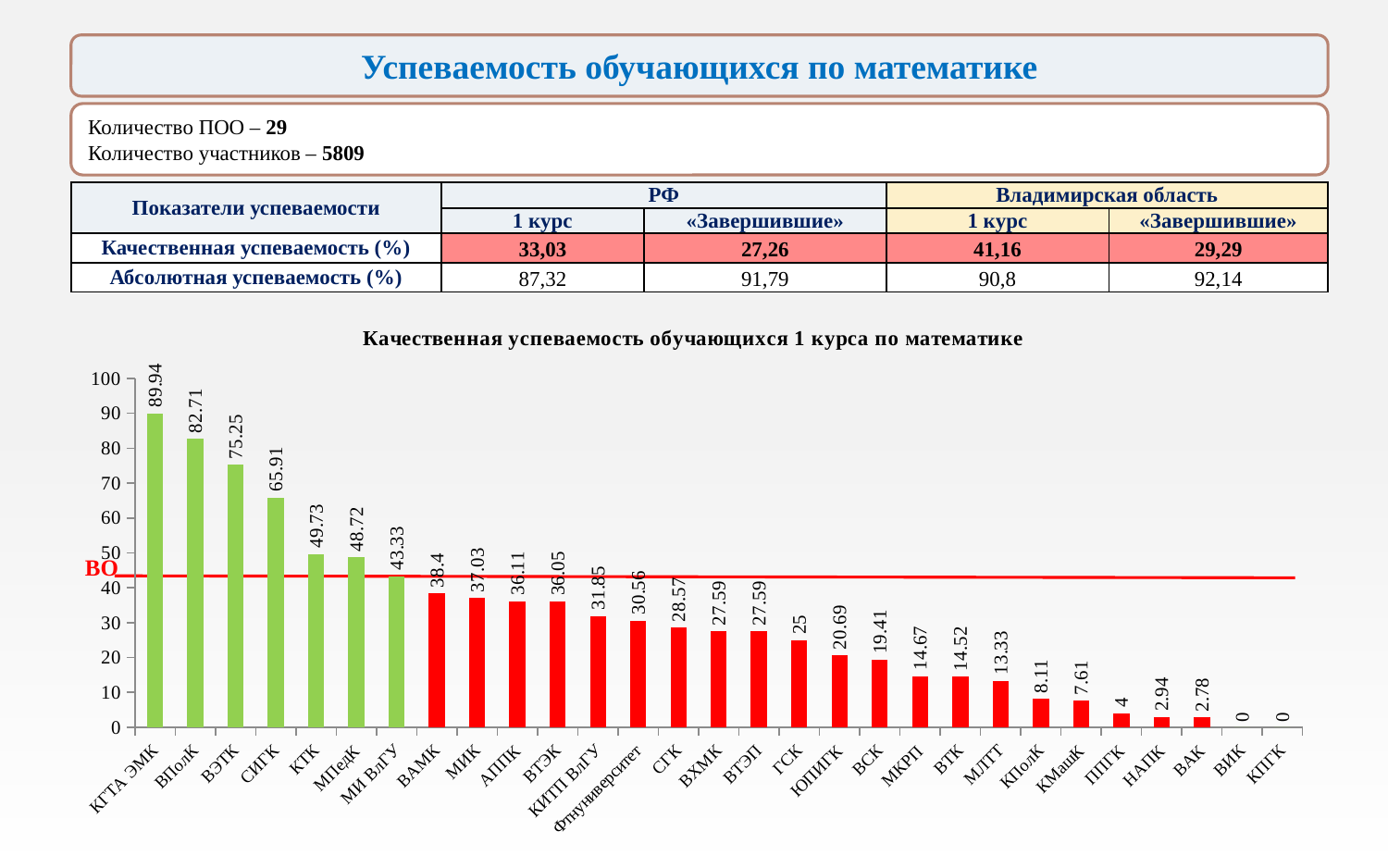
How many categories are shown on the x axis of the chart? 29 What is the value for СИГК in the chart? 65.91 How many categories in the chart have a value of 0? 2 What is the value for ГСК in the chart? 25 What is the value for КГТА ЭМК in the chart? 89.94 Do the values rise or fall from left to right along the x axis? fall What kind of chart is shown on the slide? bar chart What is the title of the chart? Качественная успеваемость обучающихся 1 курса по математике What is the difference between the values for КГТА ЭМК and ВПолК? 7.23 Which category has the highest value in the chart? КГТА ЭМК Is the value for ВАМК greater or less than 40? less Which is larger, the value for КТК or the value for МПедК? КТК